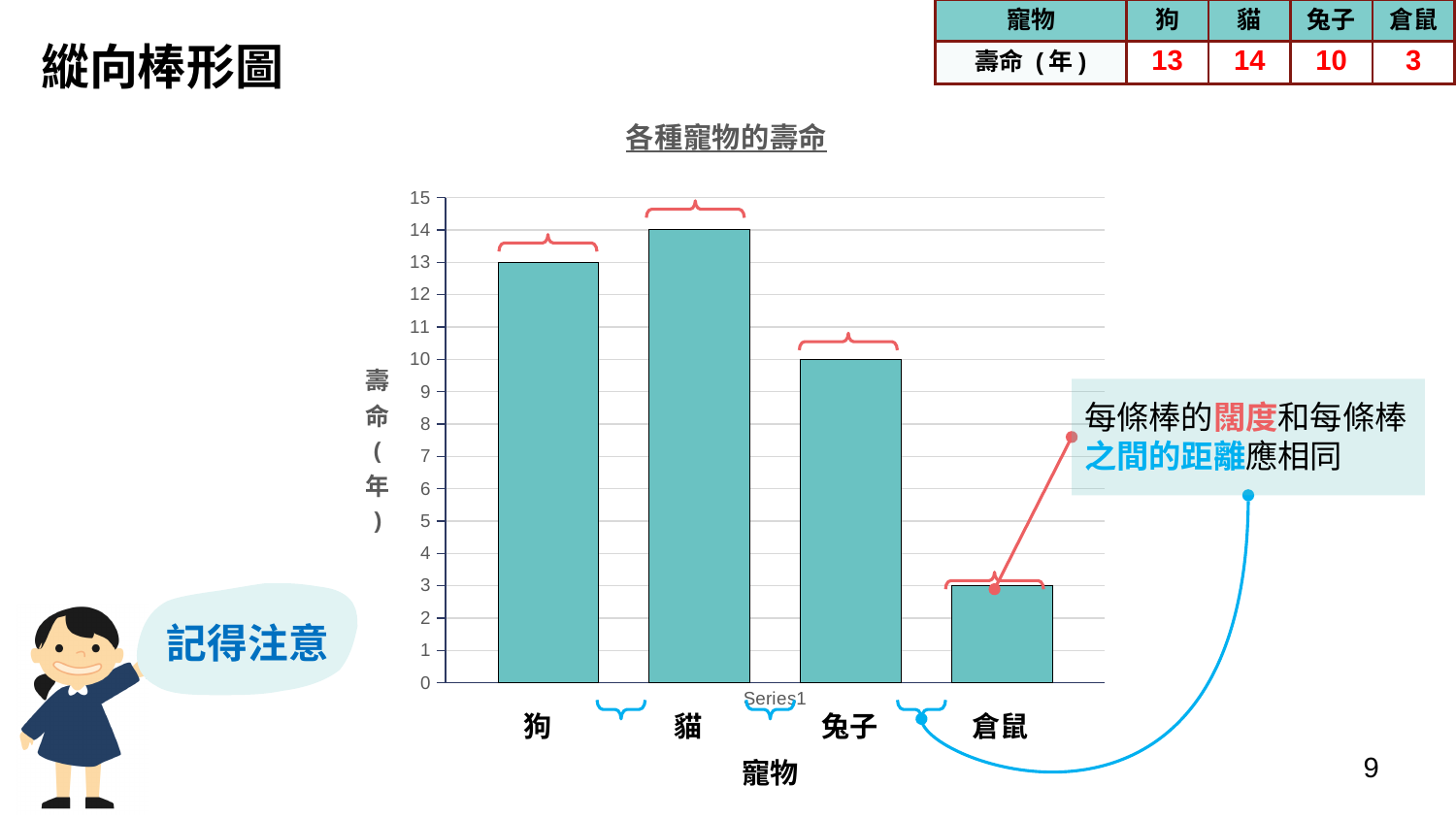
What type of chart is shown on the slide? bar chart What is the lifespan value for 兔子 in the chart? 10 What is the lifespan value for 倉鼠 in the chart? 3 How many pet categories are shown on the x axis of the chart? 4 What is the title of the chart? 各種寵物的壽命 Which pet has the highest lifespan in the chart? 貓 What is the difference between the lifespan of 貓 and 倉鼠? 11 What is the lifespan value for 貓 in the chart? 14 Which has a larger lifespan value, 狗 or 兔子? 狗 Which pet has the lowest lifespan in the chart? 倉鼠 What is the label of the y axis of the chart? 壽命（年） What is the lifespan value for 狗 in the chart? 13